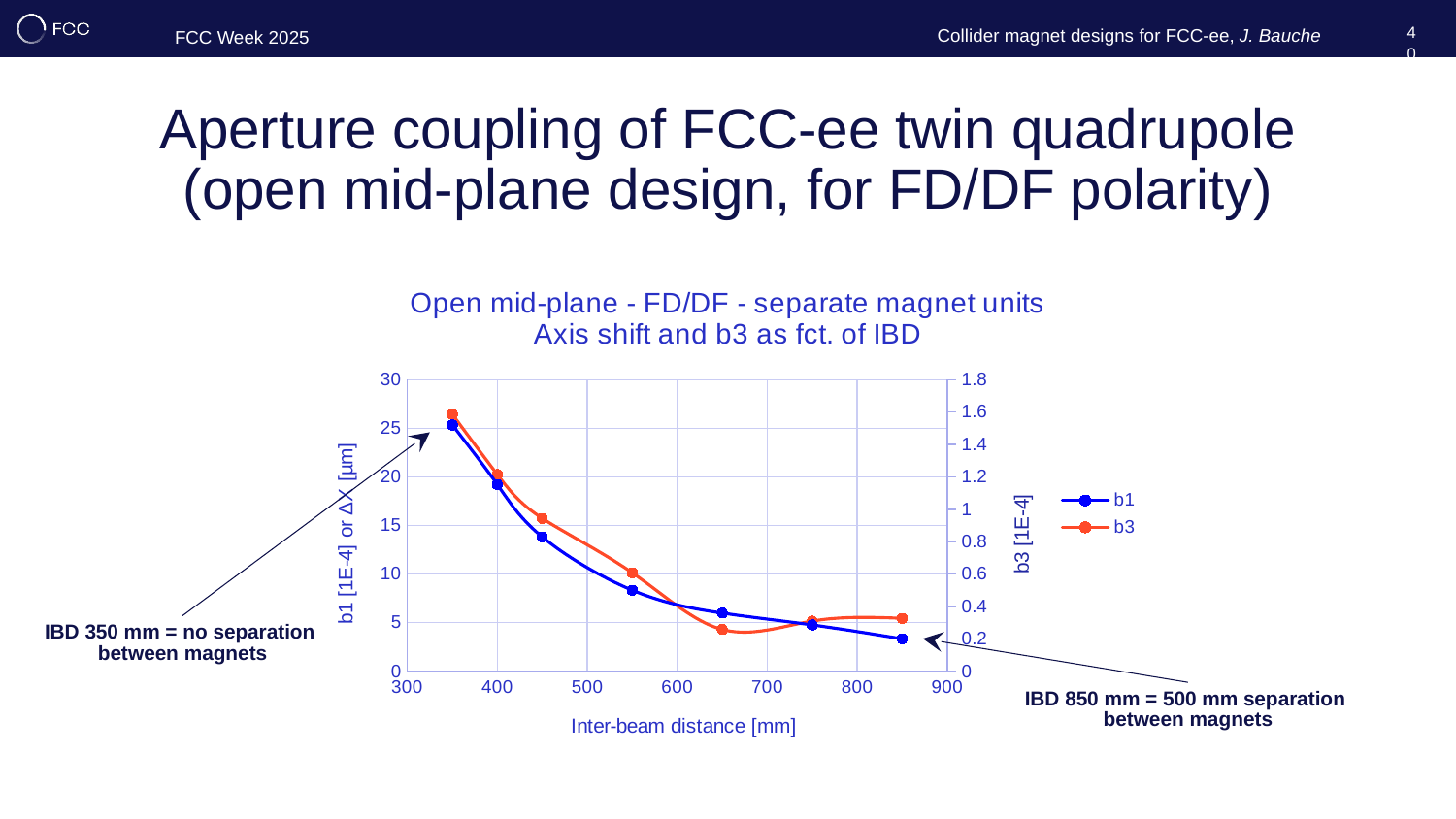
What is the label of the x axis? Inter-beam distance [mm] Is the b1 value at an inter-beam distance of 850 mm greater or less than 5? less At which inter-beam distance is the b1 value lowest? 850 How many data points are plotted for the b1 series? 7 At which inter-beam distance is the b1 value highest? 350 What are the two series named in the legend? b1 and b3 Which is larger, the b1 value at 350 mm or the b1 value at 850 mm? 350 mm How many series does the legend list? 2 What kind of chart is shown on the slide? line chart Is the b3 value at an inter-beam distance of 350 mm greater or less than 1.4 on the right axis? greater Is the b1 value at an inter-beam distance of 350 mm greater or less than 20? greater Does the b1 series rise or fall as the inter-beam distance increases? fall